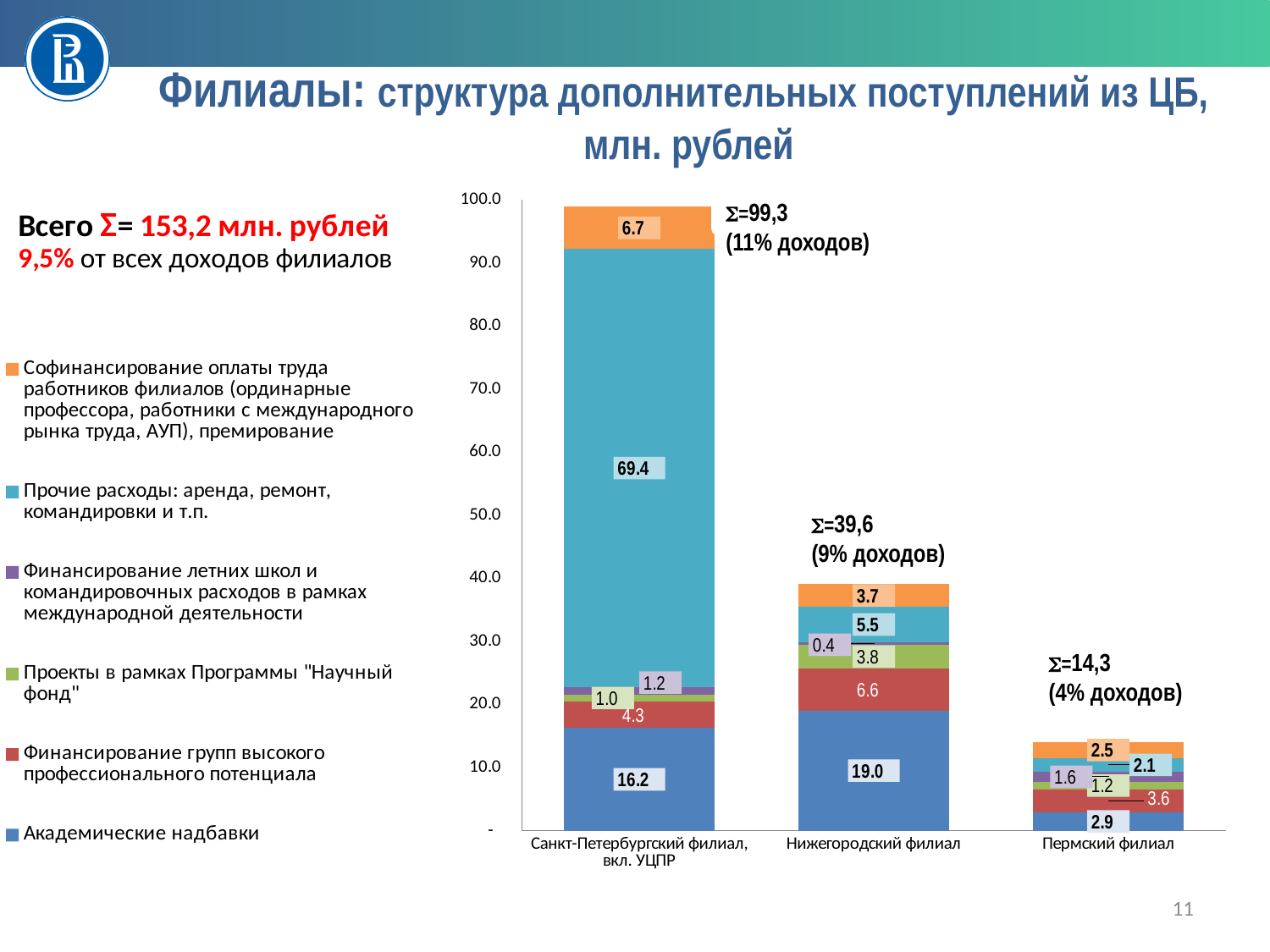
Which branch has the lowest total stacked bar? Пермский филиал Which branch has the highest total stacked bar? Санкт-Петербургский филиал, вкл. УЦПР What is the value of Прочие расходы: аренда, ремонт, командировки и т.п. for Санкт-Петербургский филиал, вкл. УЦПР? 69.4 What is the difference between the Академические надбавки values for Нижегородский филиал and Санкт-Петербургский филиал, вкл. УЦПР? 2.8 Which is larger: Финансирование групп высокого профессионального потенциала for Нижегородский филиал or for Пермский филиал? Нижегородский филиал What is the total (Σ) shown for Нижегородский филиал? 39,6 What is the value of Академические надбавки for Нижегородский филиал? 19.0 How many series does the legend list? 6 How many branches (categories) are shown on the x axis of the chart? 3 What type of chart is shown on the slide? stacked bar chart What is the value of Софинансирование оплаты труда работников филиалов for Пермский филиал? 2.5 What total amount (Всего Σ) is stated in the text on the left of the slide? 153,2 млн. рублей